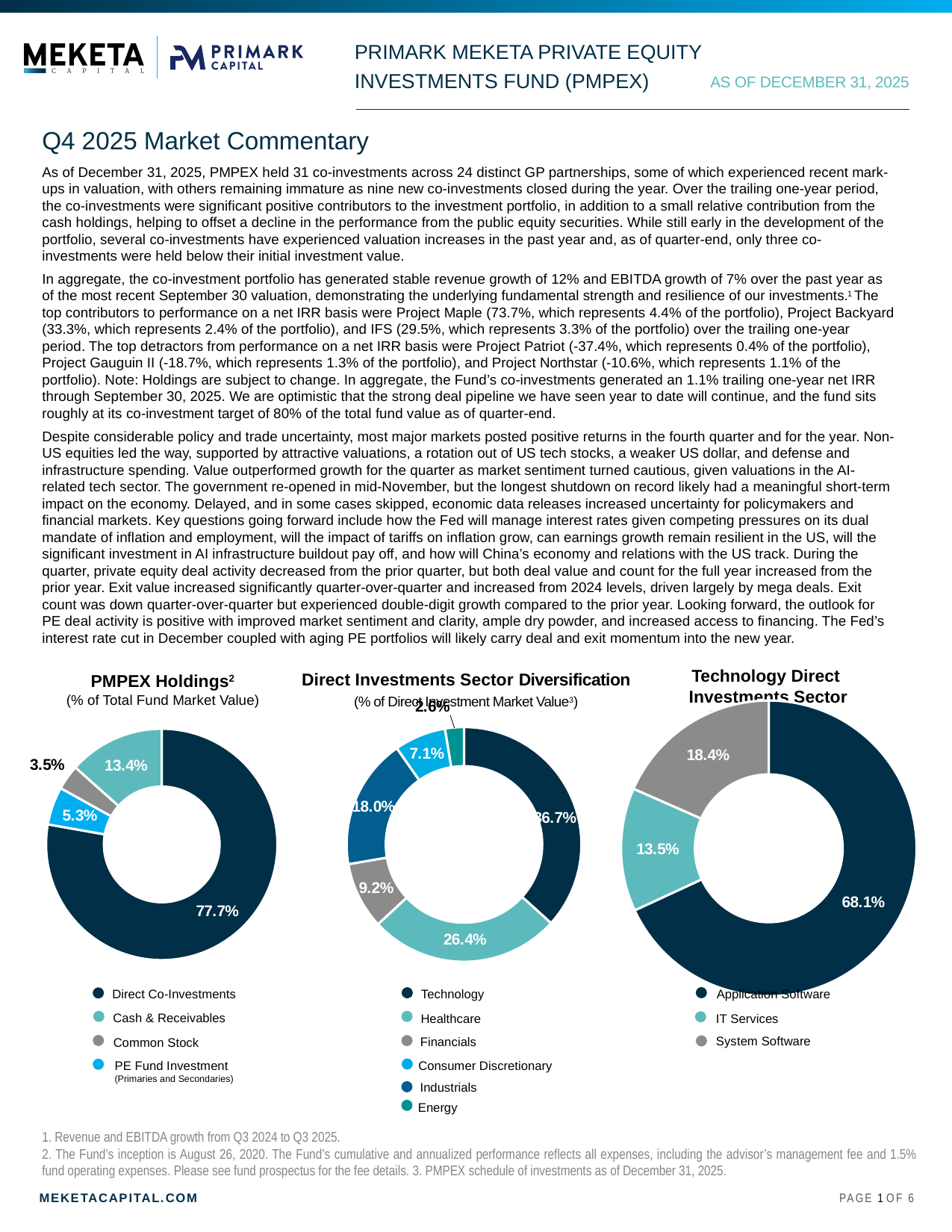
How many categories does the legend of the PMPEX Holdings chart list? 4 In the Technology Direct Investments Sector chart, what is the difference between System Software and IT Services? 4.9% In the Direct Investments Sector Diversification chart, which sector has the smallest share? Energy In the PMPEX Holdings chart, what percentage is Cash & Receivables? 13.4% In the PMPEX Holdings chart, what is the difference between the Cash & Receivables share and the PE Fund Investment share? 8.1% In the PMPEX Holdings chart, what percentage of total fund market value is Direct Co-Investments? 77.7% In the Technology Direct Investments Sector chart, what percentage is Application Software? 68.1% In the Direct Investments Sector Diversification chart, what percentage is Consumer Discretionary? 18.0% In the Direct Investments Sector Diversification chart, what percentage is Healthcare? 26.4% How many sectors does the legend of the Direct Investments Sector Diversification chart list? 6 In the PMPEX Holdings chart, which category has the smallest share? Common Stock In the Direct Investments Sector Diversification chart, which is larger, Financials or Industrials? Financials